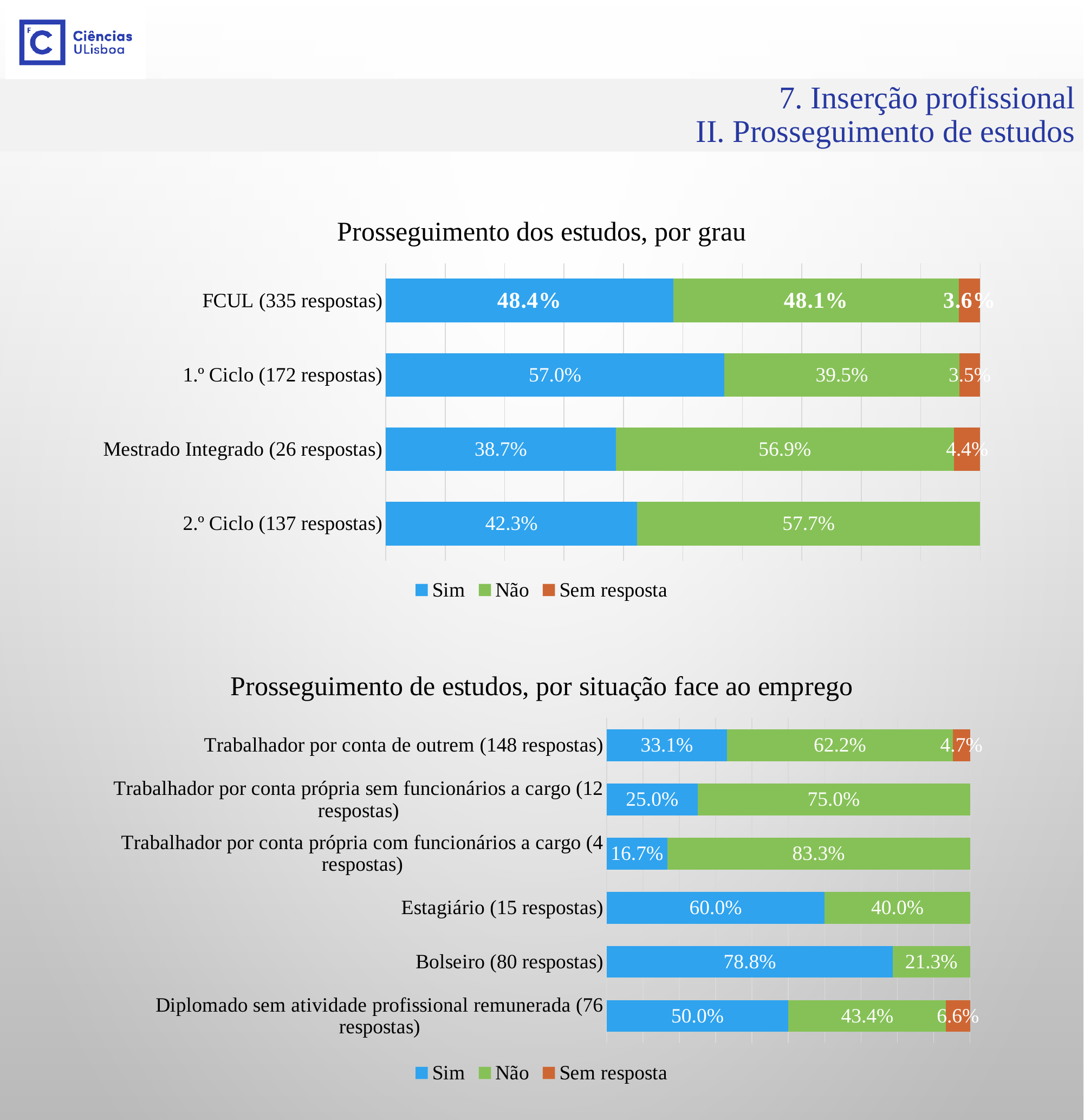
In the chart 'Prosseguimento dos estudos, por grau', what is the 'Sim' value for 1.º Ciclo (172 respostas)? 57.0% In the chart 'Prosseguimento dos estudos, por grau', how much larger is the 'Não' value than the 'Sim' value for 2.º Ciclo (137 respostas)? 15.4 percentage points How many categories are shown in the chart 'Prosseguimento dos estudos, por grau'? 4 What kind of chart is 'Prosseguimento de estudos, por situação face ao emprego'? Stacked bar chart In the chart 'Prosseguimento de estudos, por situação face ao emprego', which category has the highest 'Não' value? Trabalhador por conta própria com funcionários a cargo (4 respostas) In the chart 'Prosseguimento de estudos, por situação face ao emprego', what is the 'Sim' value for Bolseiro (80 respostas)? 78.8% In the chart 'Prosseguimento de estudos, por situação face ao emprego', what is the 'Sem resposta' value for Diplomado sem atividade profissional remunerada (76 respostas)? 6.6% In the chart 'Prosseguimento dos estudos, por grau', which category has the highest 'Sim' value? 1.º Ciclo (172 respostas) In the chart 'Prosseguimento de estudos, por situação face ao emprego', which has the larger 'Sim' value: Estagiário (15 respostas) or Trabalhador por conta de outrem (148 respostas)? Estagiário (15 respostas) In the chart 'Prosseguimento de estudos, por situação face ao emprego', which category has the lowest 'Sim' value? Trabalhador por conta própria com funcionários a cargo (4 respostas) In the chart 'Prosseguimento dos estudos, por grau', what is the 'Não' value for Mestrado Integrado (26 respostas)? 56.9% How many series does the legend list in the chart 'Prosseguimento de estudos, por situação face ao emprego'? 3